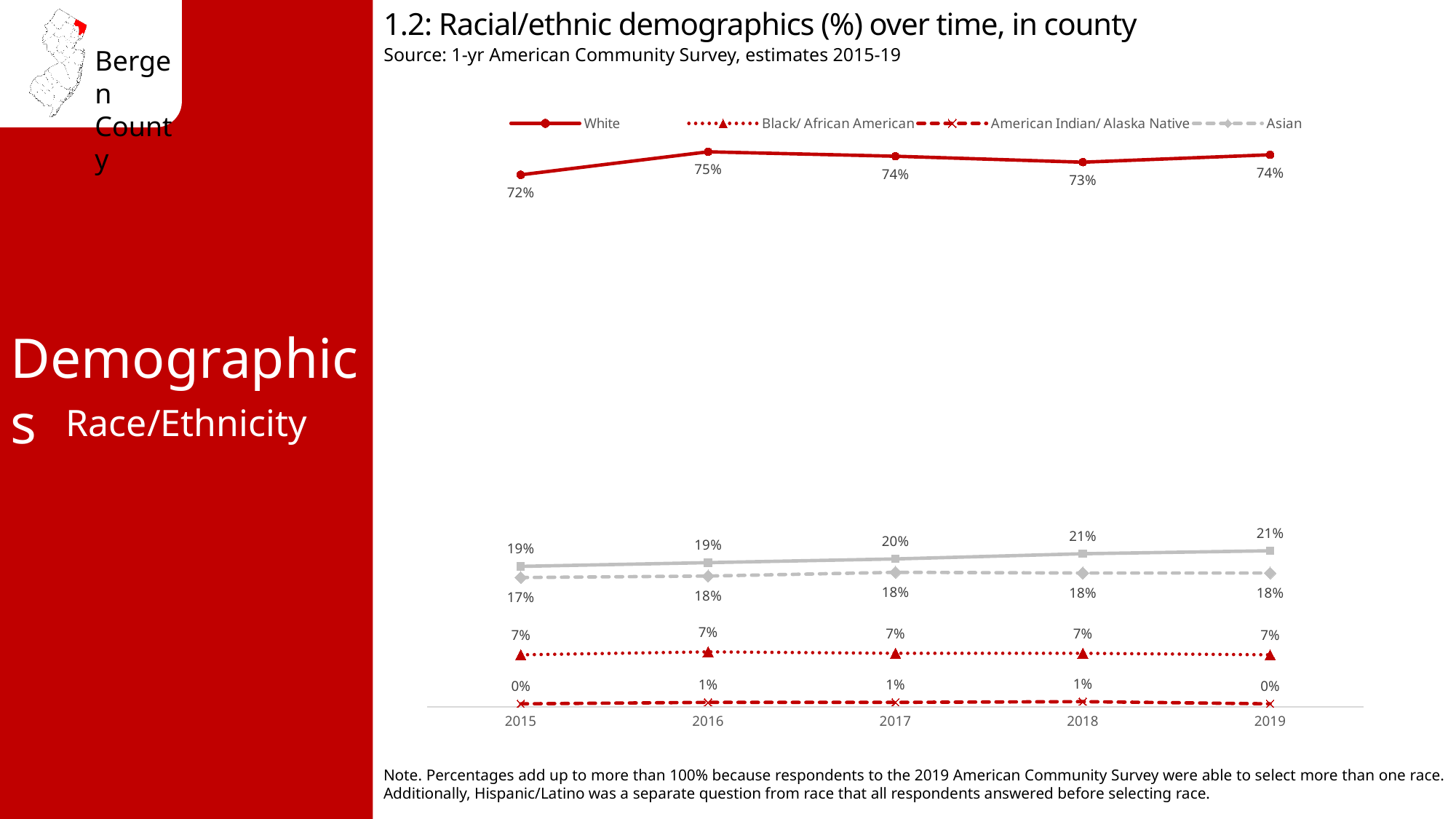
What was the White percentage in 2015? 72% Which was larger in 2018, the Asian percentage or the Black/ African American percentage? Asian What type of chart is shown on the slide? line chart What is the difference between the White percentage in 2016 and in 2015? 3% What was the Asian percentage in 2015? 17% What was the American Indian/ Alaska Native percentage in 2017? 1% What was the White percentage in 2016? 75% In which year was the White percentage highest? 2016 What was the Black/ African American percentage in 2019? 7% What is the source cited under the chart title? 1-yr American Community Survey, estimates 2015-19 How many years are shown on the x axis? 5 In which year was the White percentage lowest? 2015